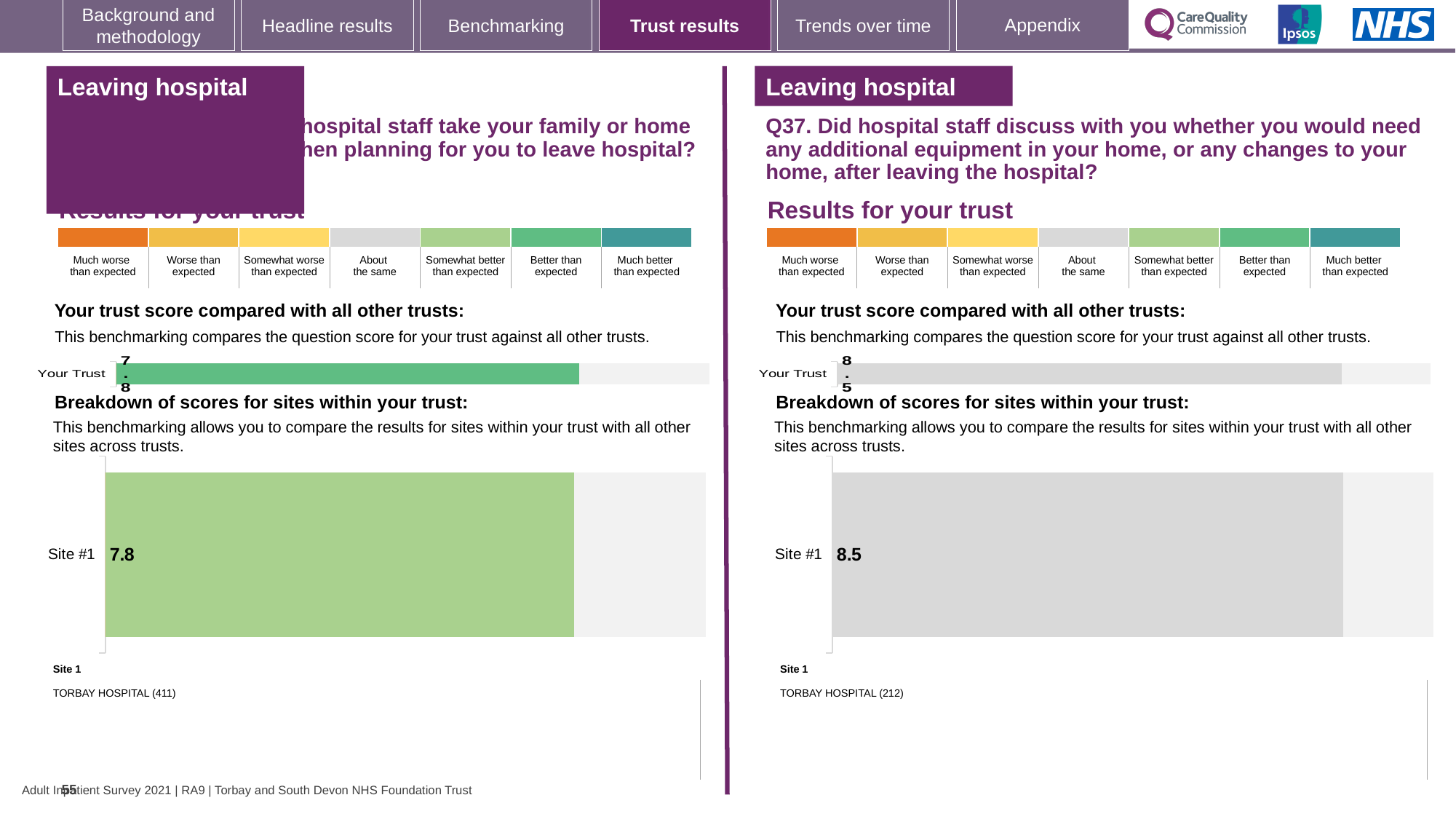
On the right half of the slide (Q37), what is the 'Your Trust' score? 8.5 Which Site #1 score is larger: the one on the left half of the slide or the one on the right half (Q37)? Right half (Q37) On the left half of the slide, what is the score shown for Site #1? 7.8 How many sites are shown in the 'Breakdown of scores for sites within your trust' chart on the right half of the slide (Q37)? 1 What is the difference between the Site #1 score on the right half of the slide (Q37) and the Site #1 score on the left half? 0.7 On the right half of the slide (Q37), what is the score shown for Site #1? 8.5 Which site name is listed under Site 1 on the left half of the slide? TORBAY HOSPITAL (411) On the left half of the slide, what is the 'Your Trust' score? 7.8 Which site name is listed under Site 1 on the right half of the slide (Q37)? TORBAY HOSPITAL (212) What kind of chart is used to show the Site #1 score on each half of the slide? Bar chart How many sites are shown in the 'Breakdown of scores for sites within your trust' chart on the left half of the slide? 1 On the right half of the slide (Q37), is the Site #1 score greater or less than 8? greater